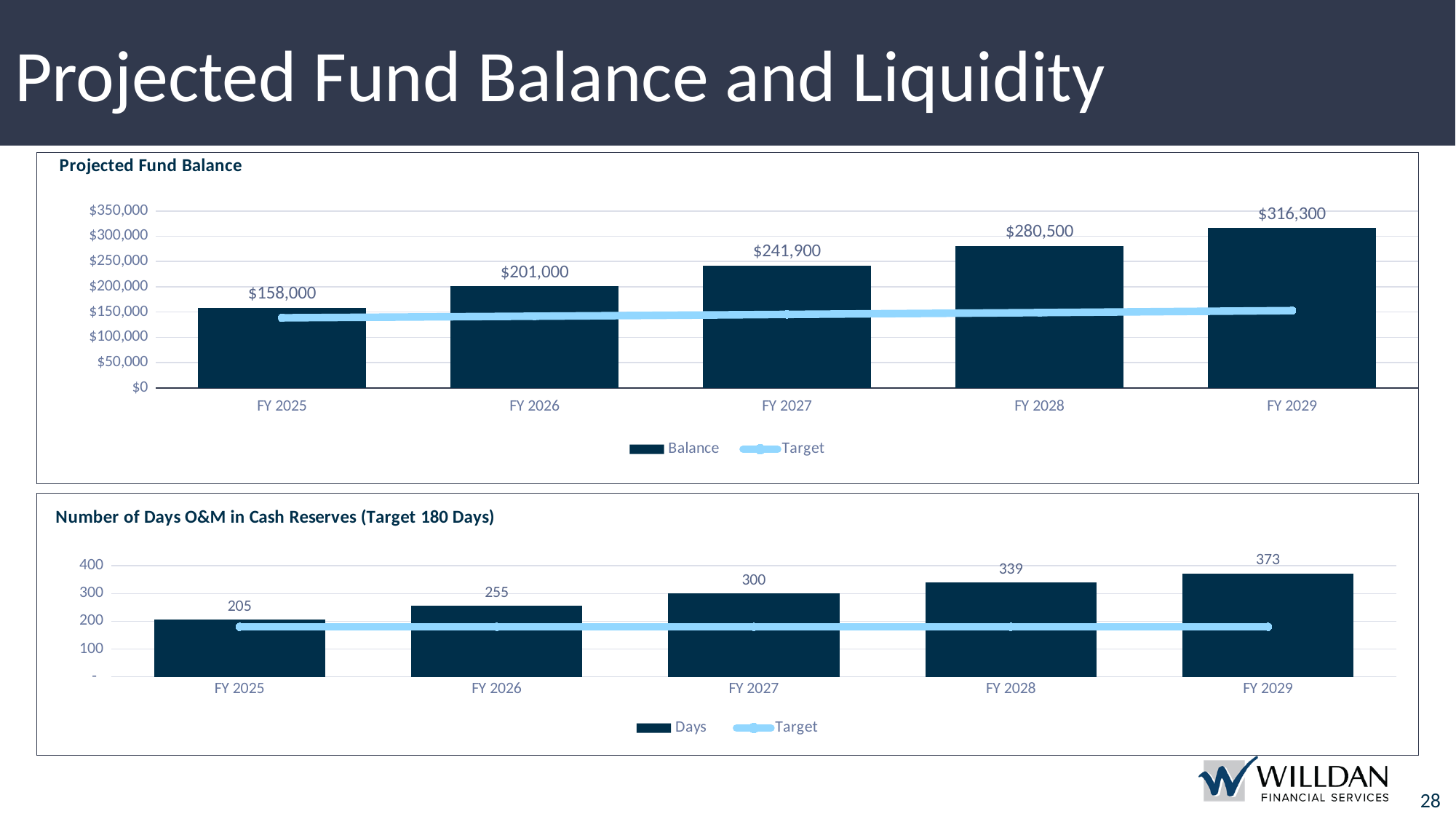
In the Number of Days O&M in Cash Reserves chart, which is larger: the days for FY 2025 or FY 2029? FY 2029 In the Projected Fund Balance chart, what is the difference between the FY 2029 and FY 2025 balances? $158,300 In the Projected Fund Balance chart, do the balances rise or fall from FY 2025 to FY 2029? rise In the Number of Days O&M in Cash Reserves chart, what is the difference in days between FY 2027 and FY 2026? 45 In the Number of Days O&M in Cash Reserves chart, how many fiscal years are plotted? 5 In the Projected Fund Balance chart, which fiscal year has the highest balance? FY 2029 In the Projected Fund Balance chart, which fiscal year has the lowest balance? FY 2025 In the Projected Fund Balance chart, how many series does the legend list? 2 In the Projected Fund Balance chart, is the FY 2026 balance greater or less than $150,000? greater In the Number of Days O&M in Cash Reserves chart, how many days are shown for FY 2028? 339 In the Projected Fund Balance chart, what is the balance for FY 2027? $241,900 What kind of chart is the Number of Days O&M in Cash Reserves chart? bar chart with a target line